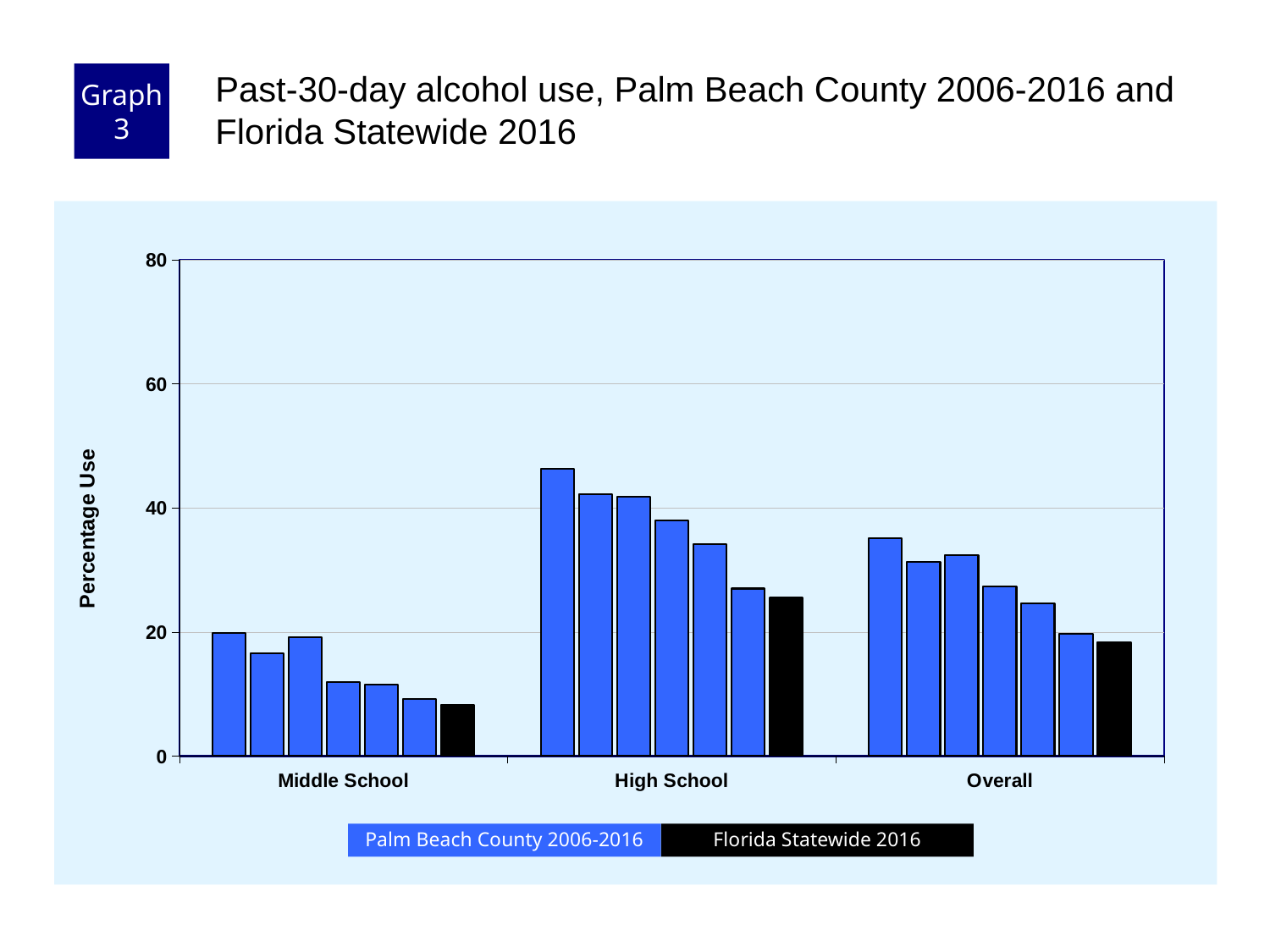
What is the label on the y axis? Percentage Use Which series is shown in black? Florida Statewide 2016 Which is larger: the Florida Statewide 2016 value for High School or for Overall? High School How many categories are shown on the x axis? 3 Is the Florida Statewide 2016 value for Middle School greater or less than 20? less How many series does the legend list? 2 Do the Palm Beach County 2006-2016 bars for High School rise or fall from left to right? Fall Which category has the lowest Florida Statewide 2016 value? Middle School Which category has the highest Florida Statewide 2016 value? High School What kind of chart is shown on the slide? Bar chart Is the Florida Statewide 2016 value for High School greater or less than 20? greater Is the tallest Palm Beach County bar for High School greater or less than 40? greater